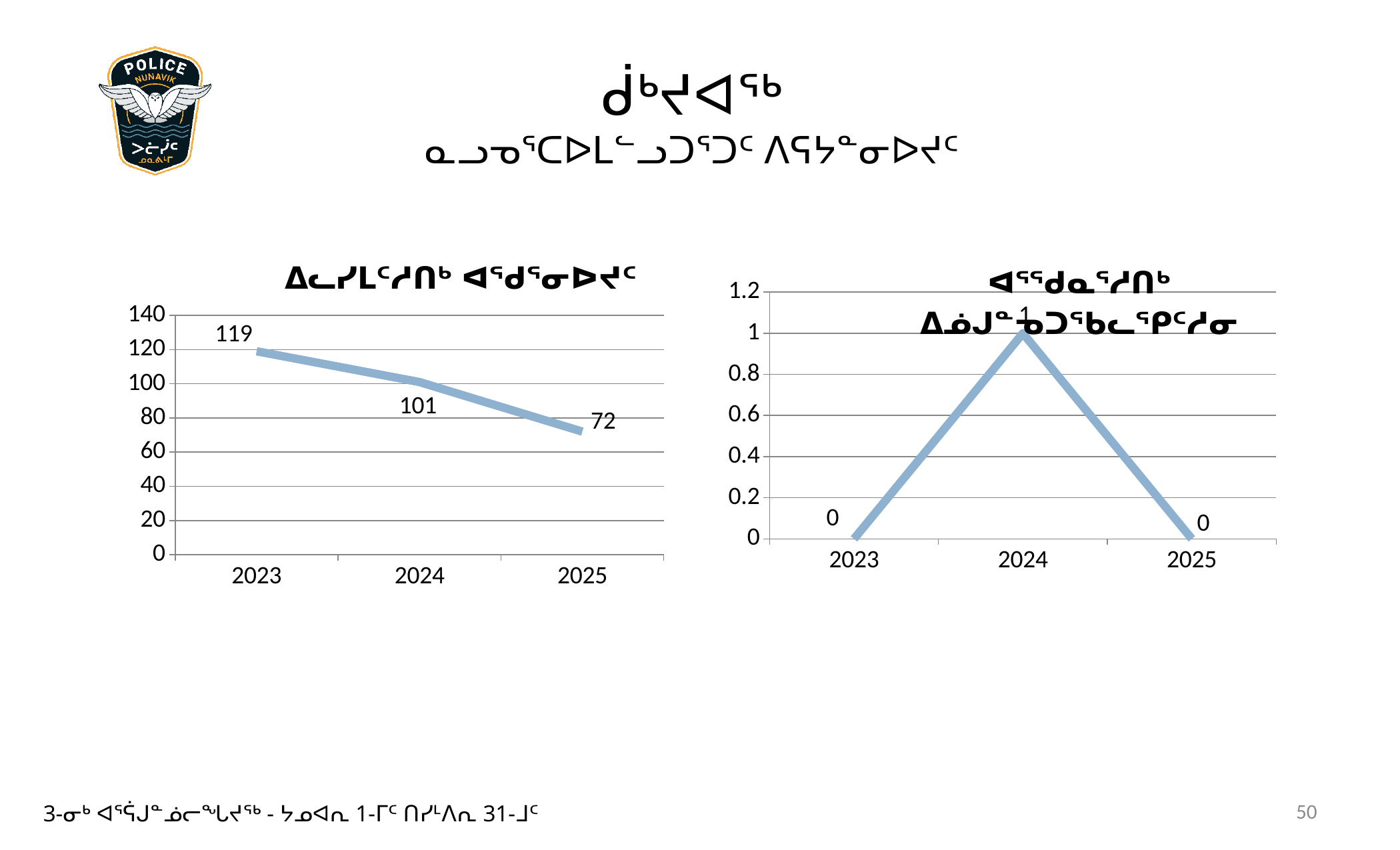
What kind of chart is the right chart? line chart On the left chart, do the values rise or fall from 2023 to 2025? fall On the left chart, which year has the highest value? 2023 On the left chart, what is the difference between the 2023 and 2025 values? 47 On the right chart, which year has the highest value? 2024 On the right chart, what is the value for 2025? 0 On the left chart, which year has the lowest value? 2025 On the left chart, what is the value for 2025? 72 On the left chart, what is the value for 2023? 119 How many years are plotted on the left chart? 3 On the right chart, what is the value for 2024? 1 On the left chart, what is the value for 2024? 101